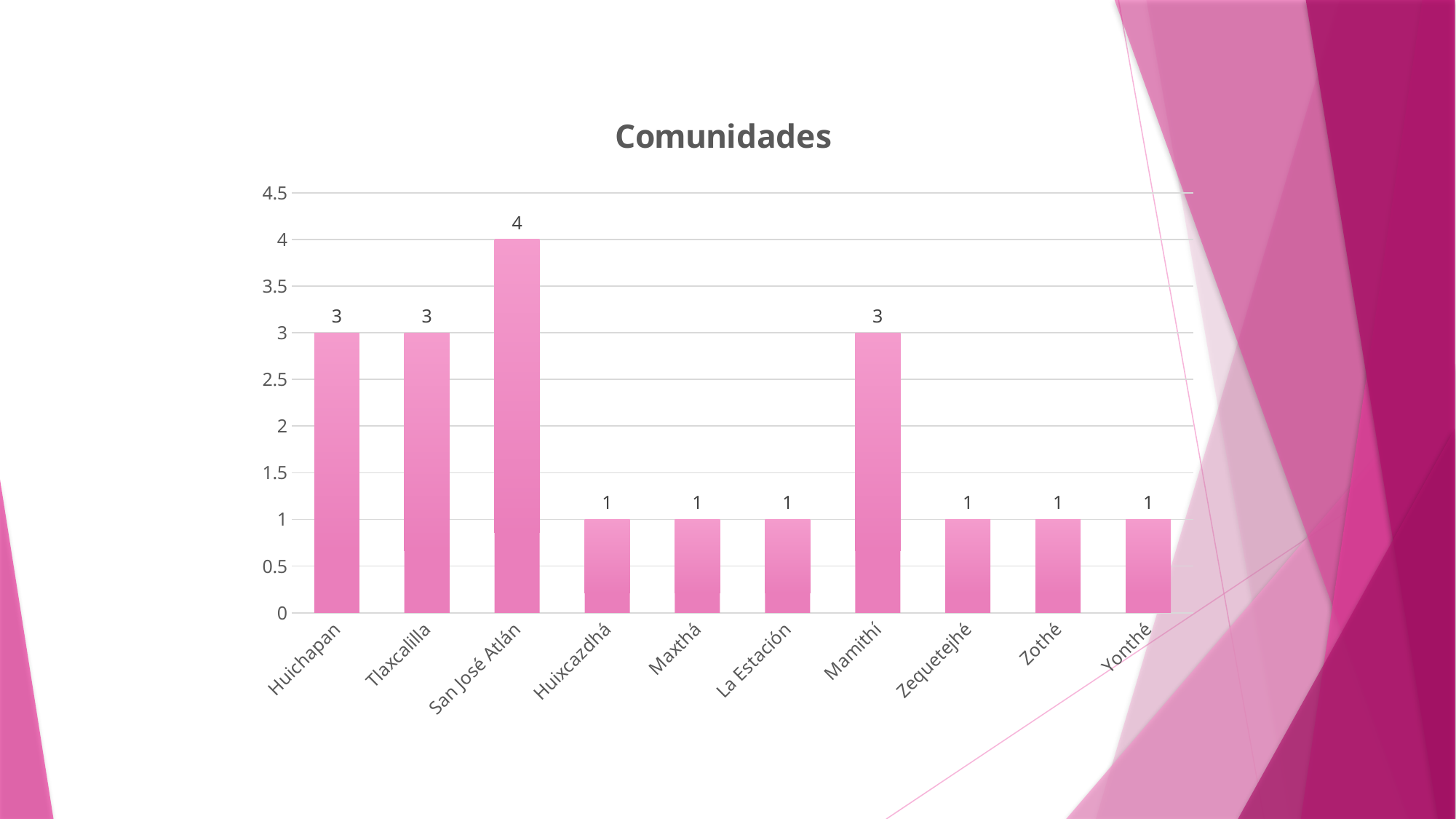
How many communities are shown on the chart? 10 What is the difference between the values for San José Atlán and Huichapan? 1 Which community has the highest value? San José Atlán Which is larger, the value for Mamithí or the value for Zothé? Mamithí How many communities have a value of 1? 6 What kind of chart is shown? Bar chart What is the title of the chart? Comunidades Is the value for San José Atlán greater or less than 3.5? greater What is the difference between the values for Tlaxcalilla and Maxthá? 2 What is the value for Zequetejhé? 1 What is the value for San José Atlán? 4 What is the value for Mamithí? 3